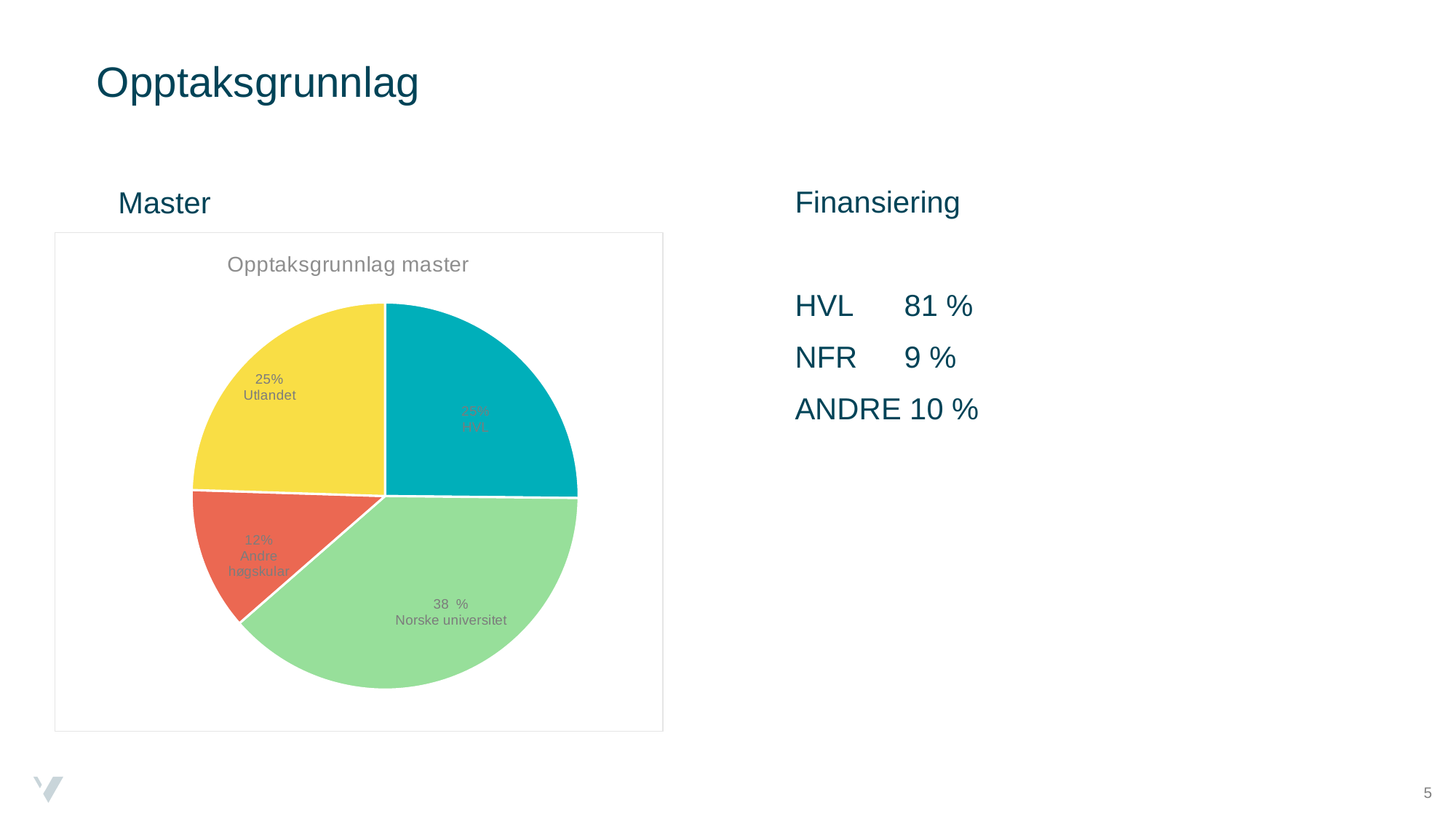
How many slices does the pie chart have? 4 Which category has the smallest slice of the pie? Andre høgskular What type of chart is shown on the slide? pie chart What is the difference in percentage points between the Norske universitet slice and the Andre høgskular slice? 26 What share of the pie is Utlandet? 25% What share of the pie is HVL? 25% Which category has the largest slice of the pie? Norske universitet What is the title of the chart? Opptaksgrunnlag master What colour is the Utlandet slice? yellow Which is larger, the slice for Norske universitet or the slice for Utlandet? Norske universitet What share of the pie is Andre høgskular? 12%